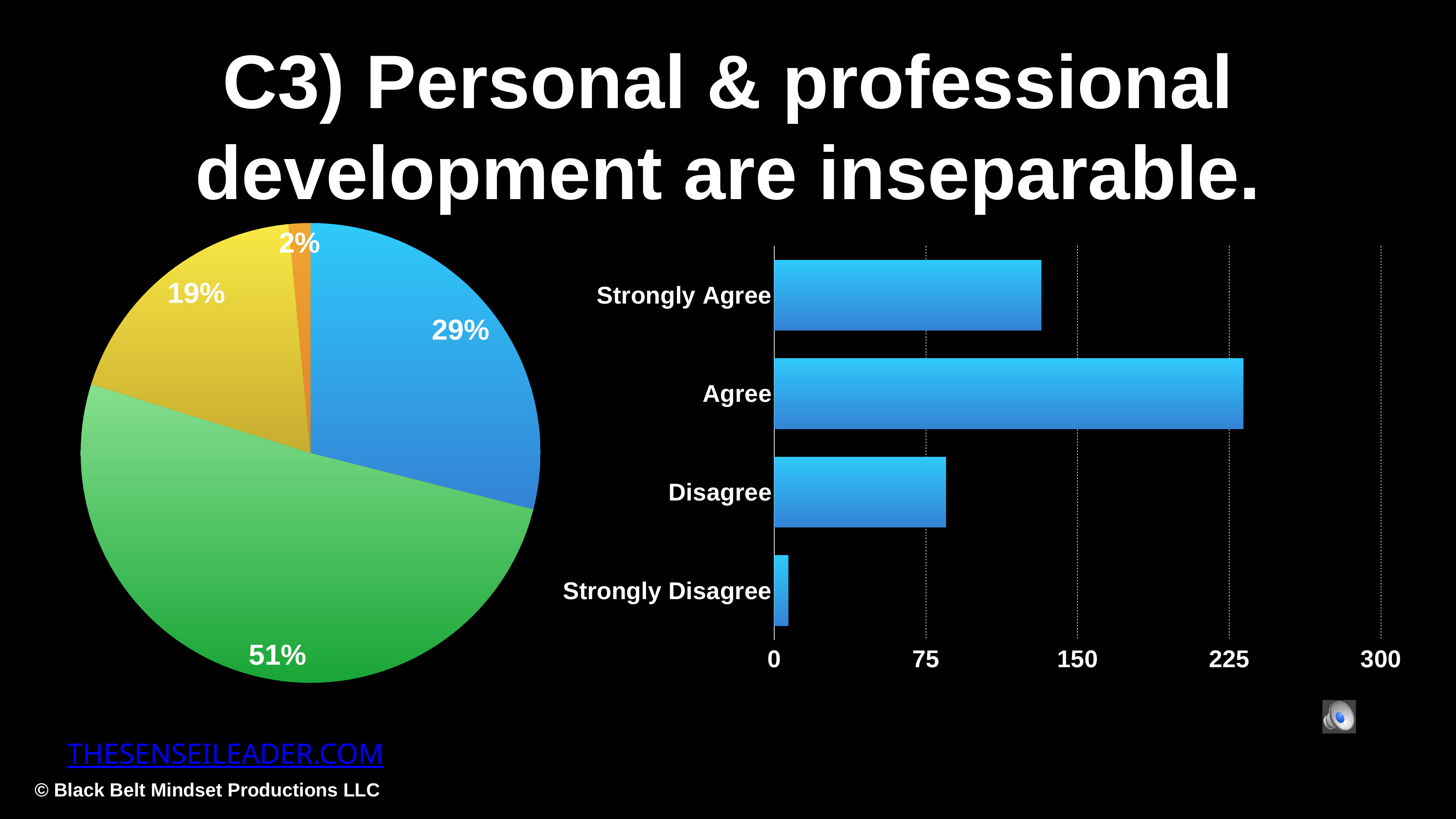
In the bar chart on the right, is the value for Strongly Agree greater or less than 150? less In the pie chart on the left, how many slices are there? 4 In the bar chart on the right, is the value for Strongly Disagree greater or less than 75? less In the pie chart on the left, what is the percentage of the largest slice? 51% What kind of chart is the chart on the right of the slide? bar chart In the bar chart on the right, how many categories are shown? 4 In the bar chart on the right, which category has the lowest value? Strongly Disagree In the bar chart on the right, is the value for Agree greater or less than 150? greater In the bar chart on the right, which is larger: the value for Strongly Agree or the value for Disagree? Strongly Agree In the pie chart on the left, what is the percentage of the smallest slice? 2% What kind of chart is the chart on the left of the slide? pie chart In the bar chart on the right, which category has the highest value? Agree